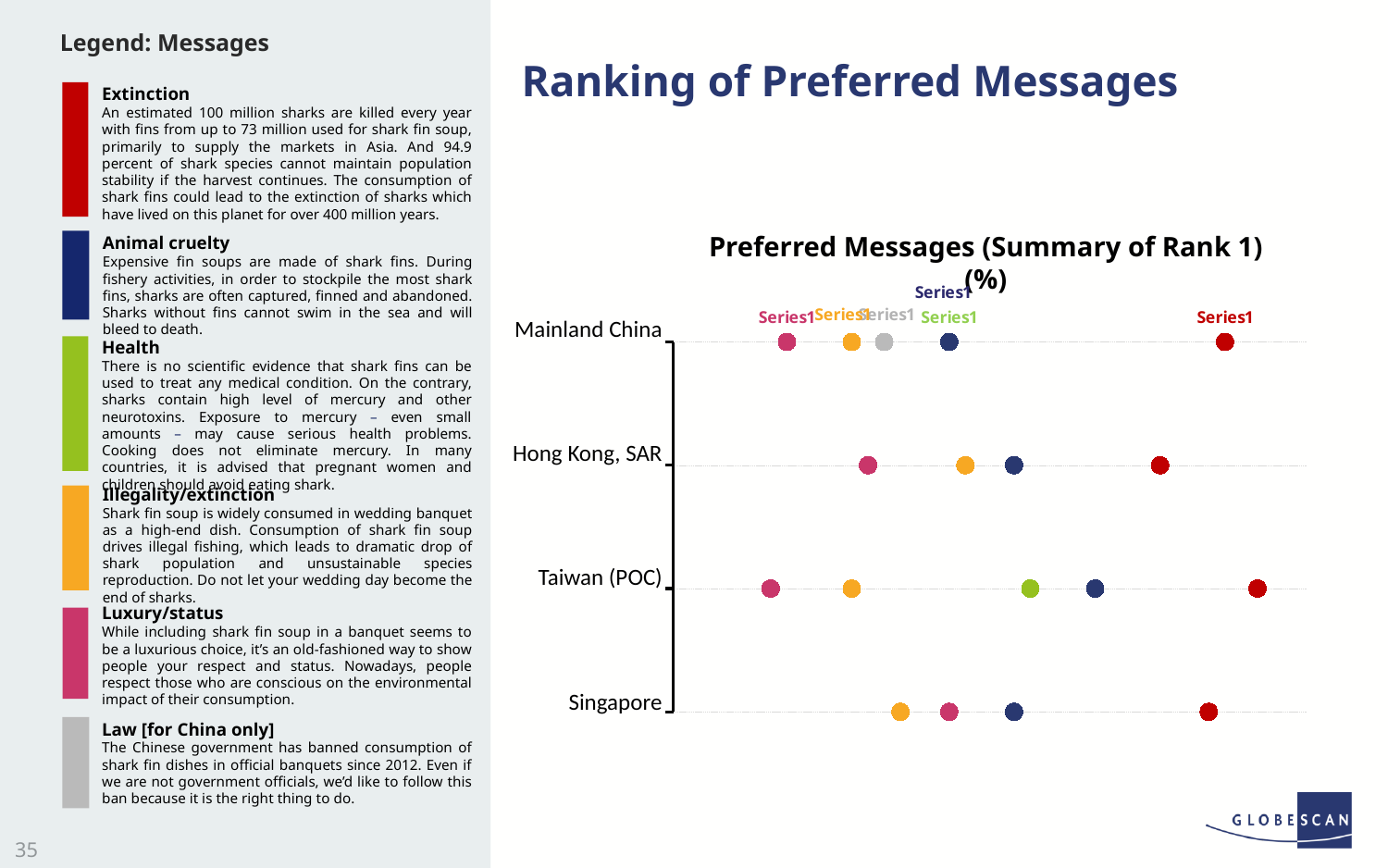
For Singapore, which coloured dot is positioned furthest to the left? Orange Which region is the only one with a grey dot plotted? Mainland China How many categories (regions) are shown on the vertical axis of the chart? 4 How many dots are plotted for Mainland China? 5 What kind of chart is shown on the slide? Dot plot (scatter chart) What is the title of the chart? Preferred Messages (Summary of Rank 1) (%) For Mainland China, which coloured dot is positioned furthest to the right? Red For Singapore, which coloured dot is positioned furthest to the right? Red For Taiwan (POC), which coloured dot is positioned furthest to the left? Pink How many dots are plotted for Hong Kong, SAR? 4 For Hong Kong, SAR, is the red dot or the pink dot further to the right? Red For Taiwan (POC), is the green dot or the navy blue dot further to the right? Navy blue